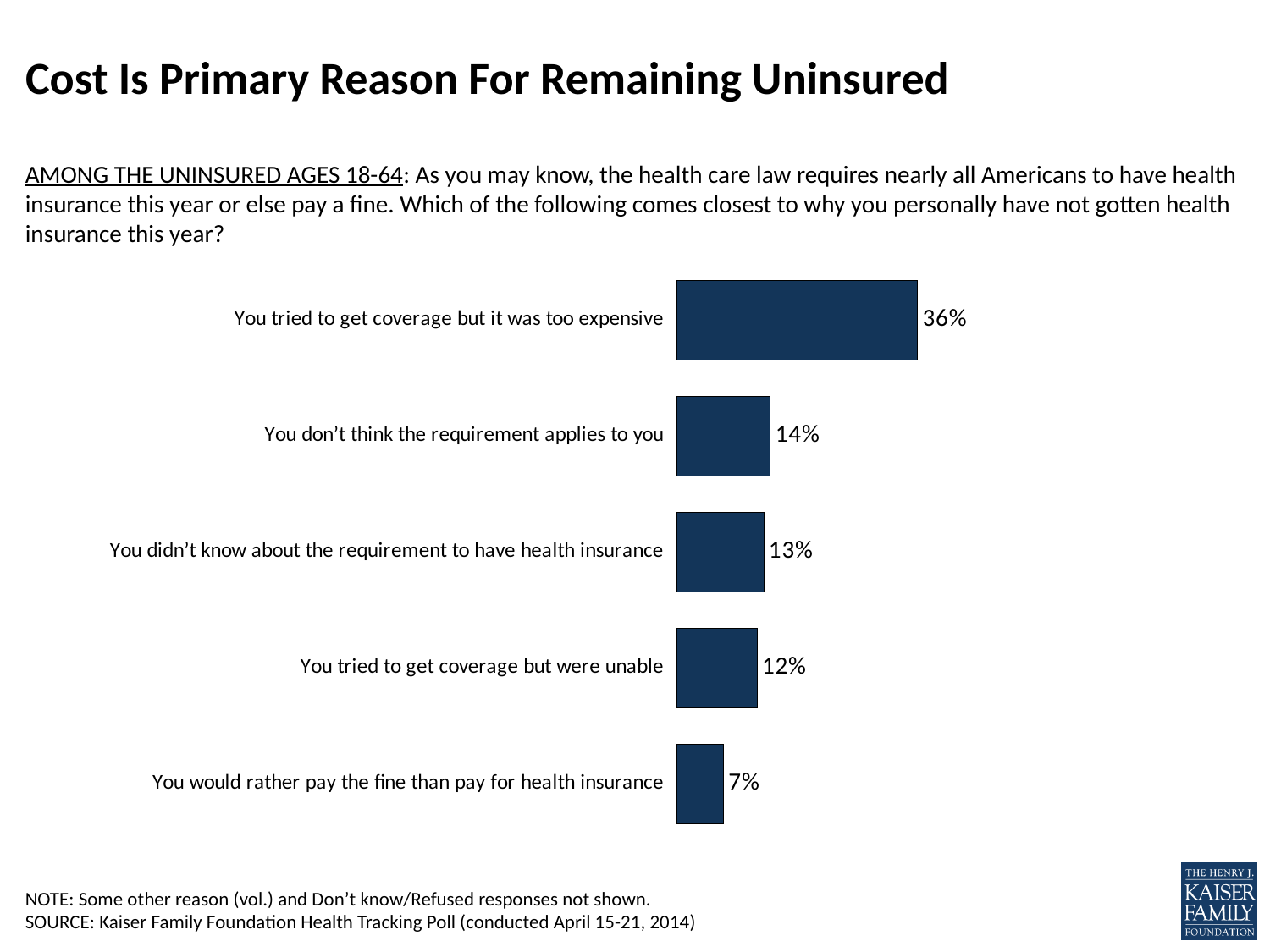
Which is larger: the share who don't think the requirement applies to them or the share who tried to get coverage but were unable? You don't think the requirement applies to you Which reason has the lowest percentage? You would rather pay the fine than pay for health insurance What percentage said they would rather pay the fine than pay for health insurance? 7% Which reason has the highest percentage? You tried to get coverage but it was too expensive What type of chart is shown on the slide? Bar chart What percentage said they tried to get coverage but were unable? 12% What percentage of uninsured adults said they tried to get coverage but it was too expensive? 36% What is the difference in percentage points between 'tried to get coverage but it was too expensive' and 'would rather pay the fine than pay for health insurance'? 29 percentage points What percentage said they didn't know about the requirement to have health insurance? 13% How many reasons are shown in the chart? 5 What percentage said they don't think the requirement applies to them? 14% What is the title of the slide? Cost Is Primary Reason For Remaining Uninsured